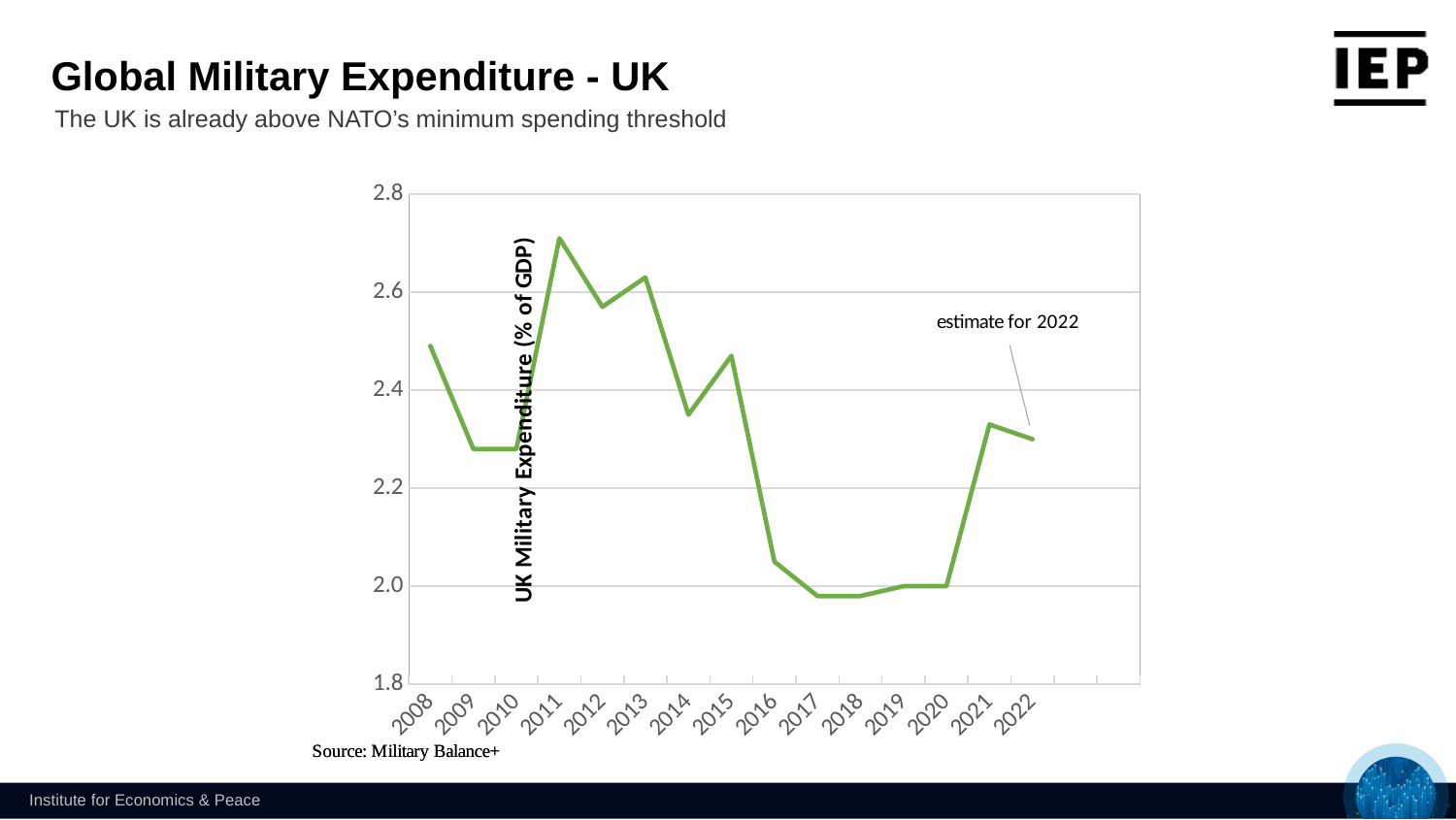
Is the value for 2008 greater or less than 2.4? greater Is the value for 2011 greater or less than 2.6? greater Which year has the larger value, 2011 or 2016? 2011 Does the line rise or fall between 2013 and 2017? fall Is the value for 2014 greater or less than 2.4? less What does the annotation pointing to the last data point say? estimate for 2022 What kind of chart is shown on the slide? line chart Which year has the larger value, 2013 or 2014? 2013 In which year is UK military expenditure (% of GDP) highest? 2011 What is the label on the y axis of the chart? UK Military Expenditure (% of GDP) How many years are plotted on the x axis of the chart? 15